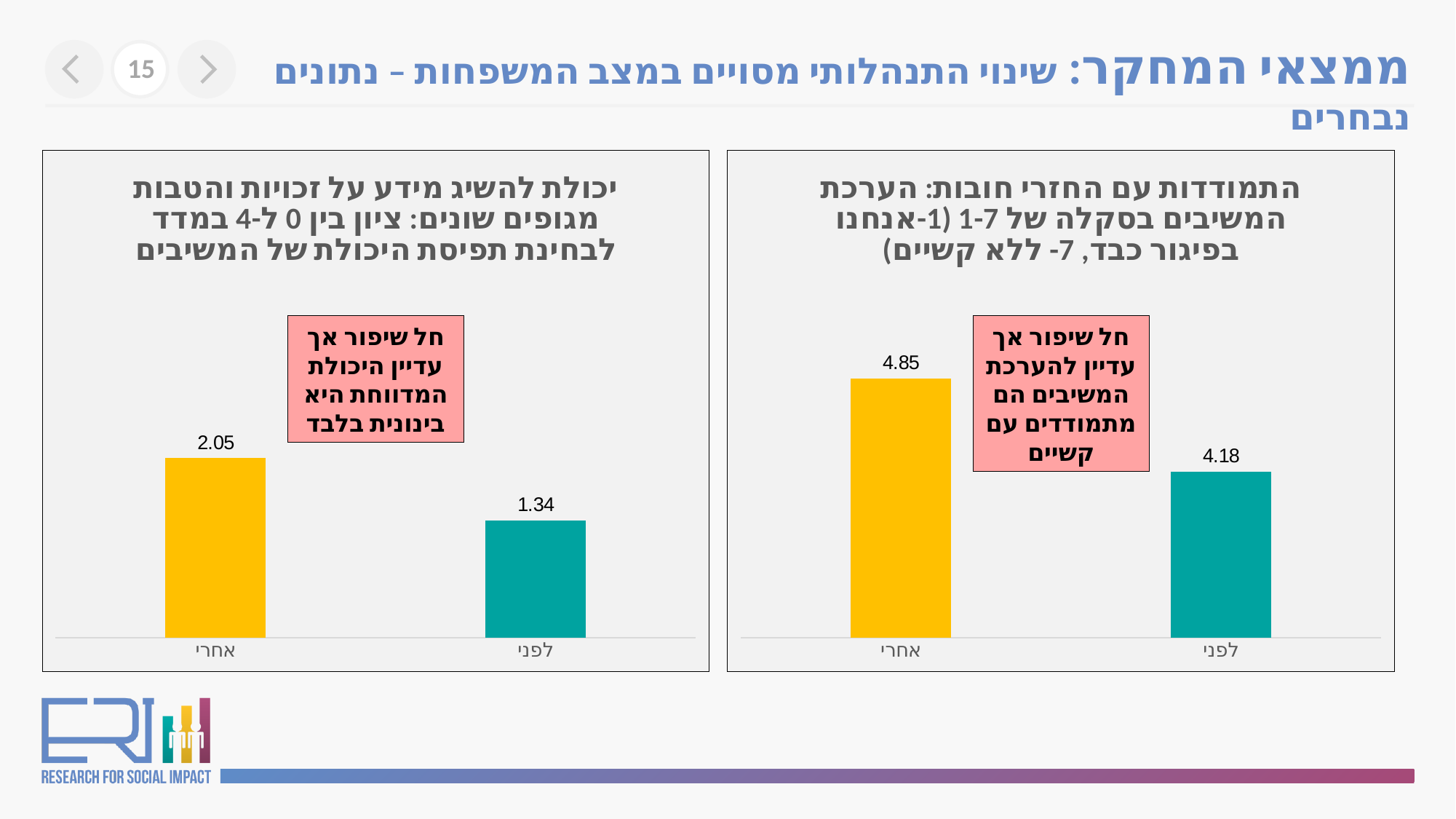
In the right chart (התמודדות עם החזרי חובות), what is the value for לפני? 4.18 In the left chart, which category has the higher value, אחרי or לפני? אחרי In the right chart (התמודדות עם החזרי חובות), what is the value for אחרי? 4.85 In the left chart, what is the difference between the values for אחרי and לפני? 0.71 In the left chart (יכולת להשיג מידע על זכויות והטבות), what is the value for אחרי? 2.05 In the right chart, which category has the lowest value? לפני How many charts are shown on the slide? 2 In the right chart, what colour is the bar for אחרי? Yellow In the right chart, what is the difference between the values for אחרי and לפני? 0.67 What type of chart is the left chart? Bar chart In the left chart (יכולת להשיג מידע על זכויות והטבות), what is the value for לפני? 1.34 How many bars are shown in the right chart? 2